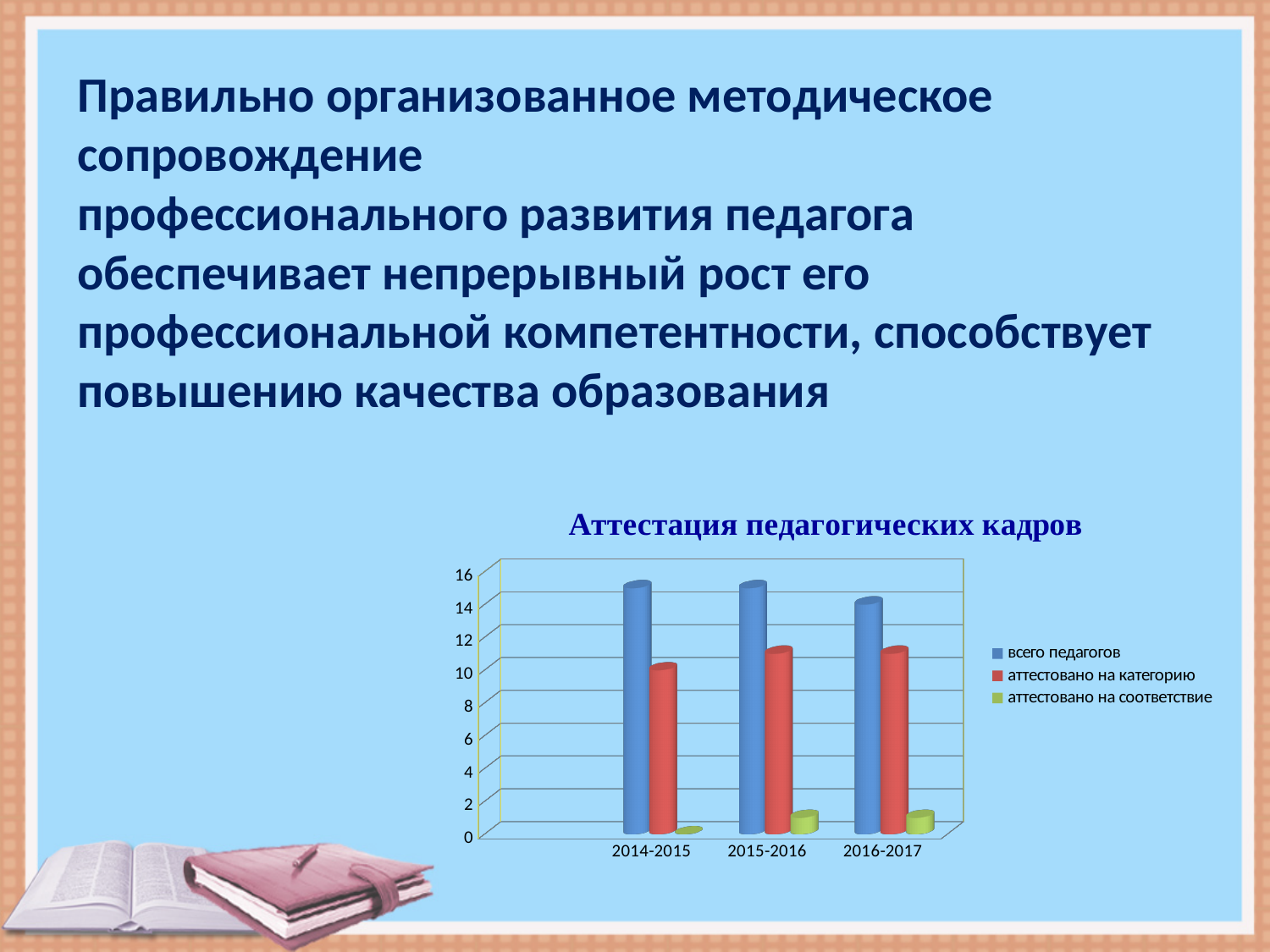
Is the value for аттестовано на соответствие in 2014-2015 greater or less than 2? less Is the value for всего педагогов in 2014-2015 greater or less than 12? greater Which series has the lowest value in 2016-2017? аттестовано на соответствие How many categories (school years) are shown on the x axis? 3 What is the title of the chart? Аттестация педагогических кадров Which series has the highest value in 2015-2016? всего педагогов Is the value for аттестовано на категорию in 2014-2015 greater or less than 12? less What kind of chart is shown on the slide? bar chart Which series is shown in green in the legend? аттестовано на соответствие In 2015-2016, which is larger: всего педагогов or аттестовано на категорию? всего педагогов How many series does the chart legend list? 3